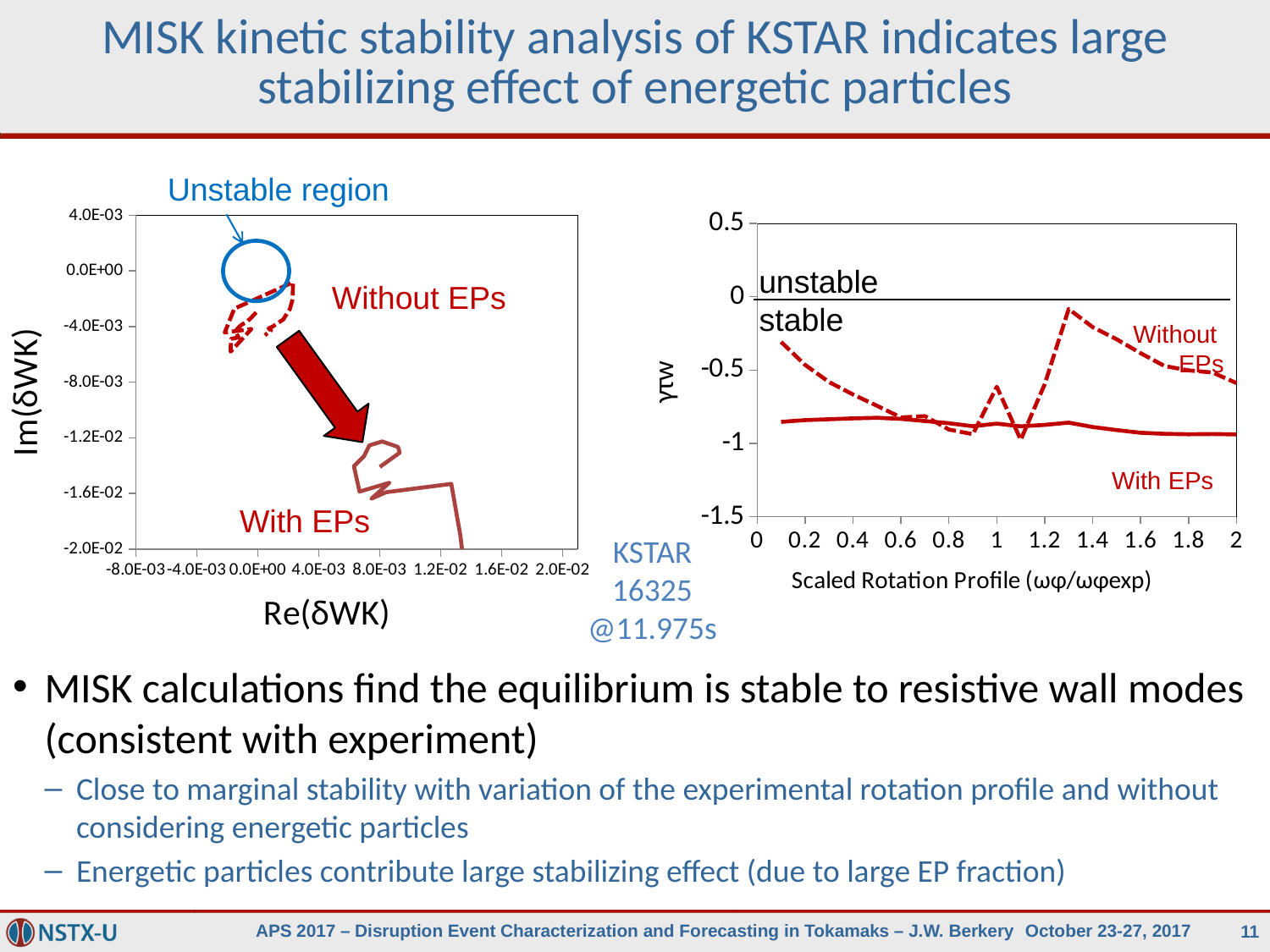
On the right chart (γτw vs Scaled Rotation Profile), at a scaled rotation of 0.2, which series has the larger γτw, With EPs or Without EPs? Without EPs On the right chart (γτw vs Scaled Rotation Profile), how many series are plotted? 2 On the right chart (γτw vs Scaled Rotation Profile), what is the label of the x axis? Scaled Rotation Profile (ωφ/ωφexp) On the left chart (Im(δWK) vs Re(δWK)), what is the label of the y axis? Im(δWK) On the right chart (γτw vs Scaled Rotation Profile), what kind of chart is it? line chart On the right chart (γτw vs Scaled Rotation Profile), is the value of γτw for Without EPs at a scaled rotation of 1.3 greater or less than -0.5? greater On the left chart (Im(δWK) vs Re(δWK)), are the Im(δWK) values of the With EPs curve greater or less than -8.0E-03? less On the left chart (Im(δWK) vs Re(δWK)), which series has the larger Im(δWK) values, With EPs or Without EPs? Without EPs On the right chart (γτw vs Scaled Rotation Profile), is the value of γτw for Without EPs at a scaled rotation of 2 greater or less than -1? greater On the left chart (Im(δWK) vs Re(δWK)), how many series are plotted? 3 On the right chart (γτw vs Scaled Rotation Profile), does the Without EPs curve rise or fall as the scaled rotation goes from 1.3 to 2? fall